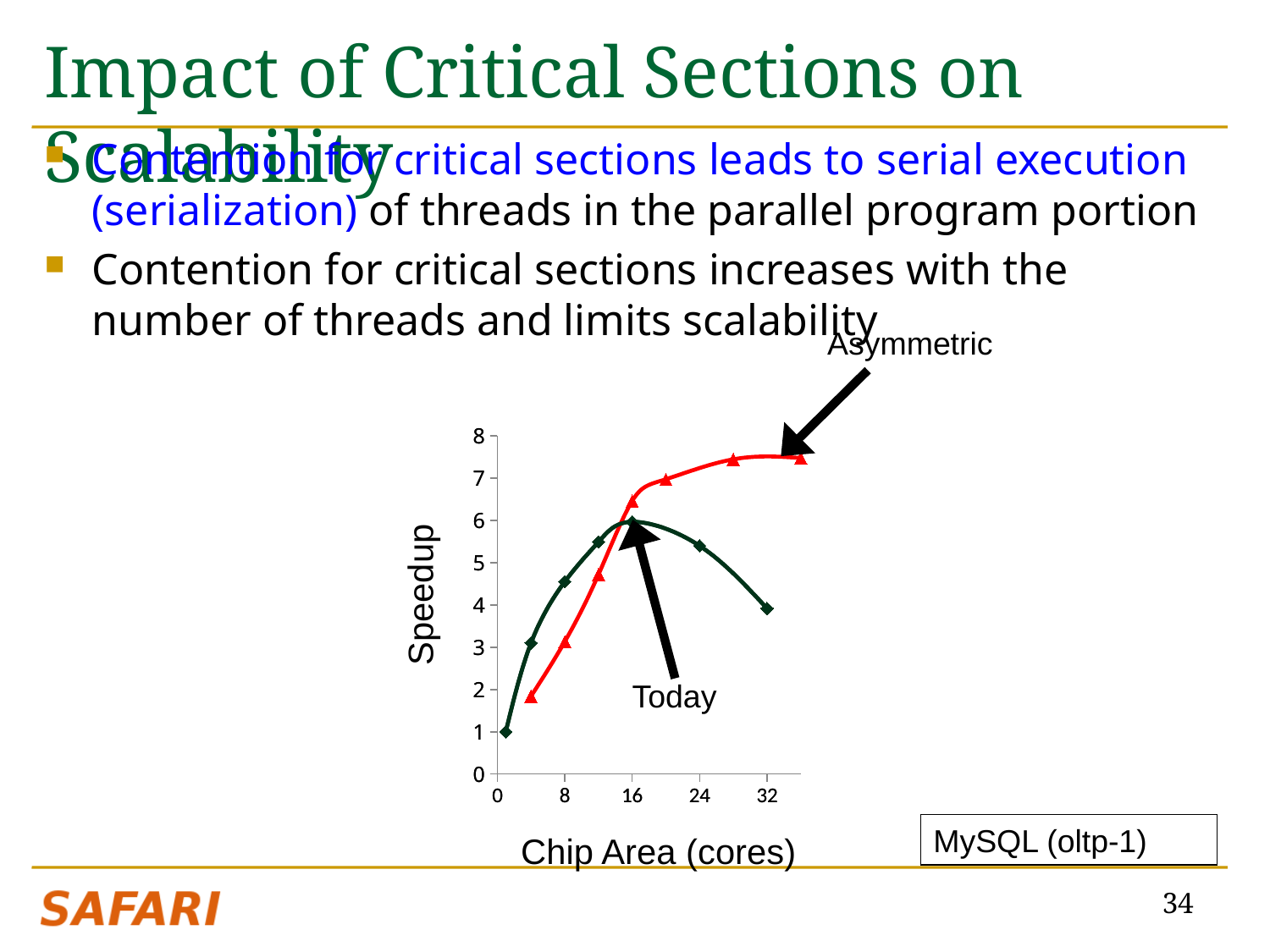
At 32 cores, which series has the higher speedup, Today or Asymmetric? Asymmetric At which chip area does the Today series reach its highest speedup? 16 cores What is the label of the x axis of the chart? Chip Area (cores) Does the speedup of the Asymmetric series rise or fall as chip area increases? rise Does the speedup of the Today series rise or fall as chip area increases beyond 16 cores? fall Is the speedup of the Today series at 32 cores greater or less than 5? less What kind of chart is shown on the slide? line chart How many series are plotted in the chart? 2 Is the speedup of the Asymmetric series at 32 cores greater or less than 7? greater Is the speedup of the Asymmetric series at 8 cores greater or less than 4? greater What is the label of the y axis of the chart? Speedup